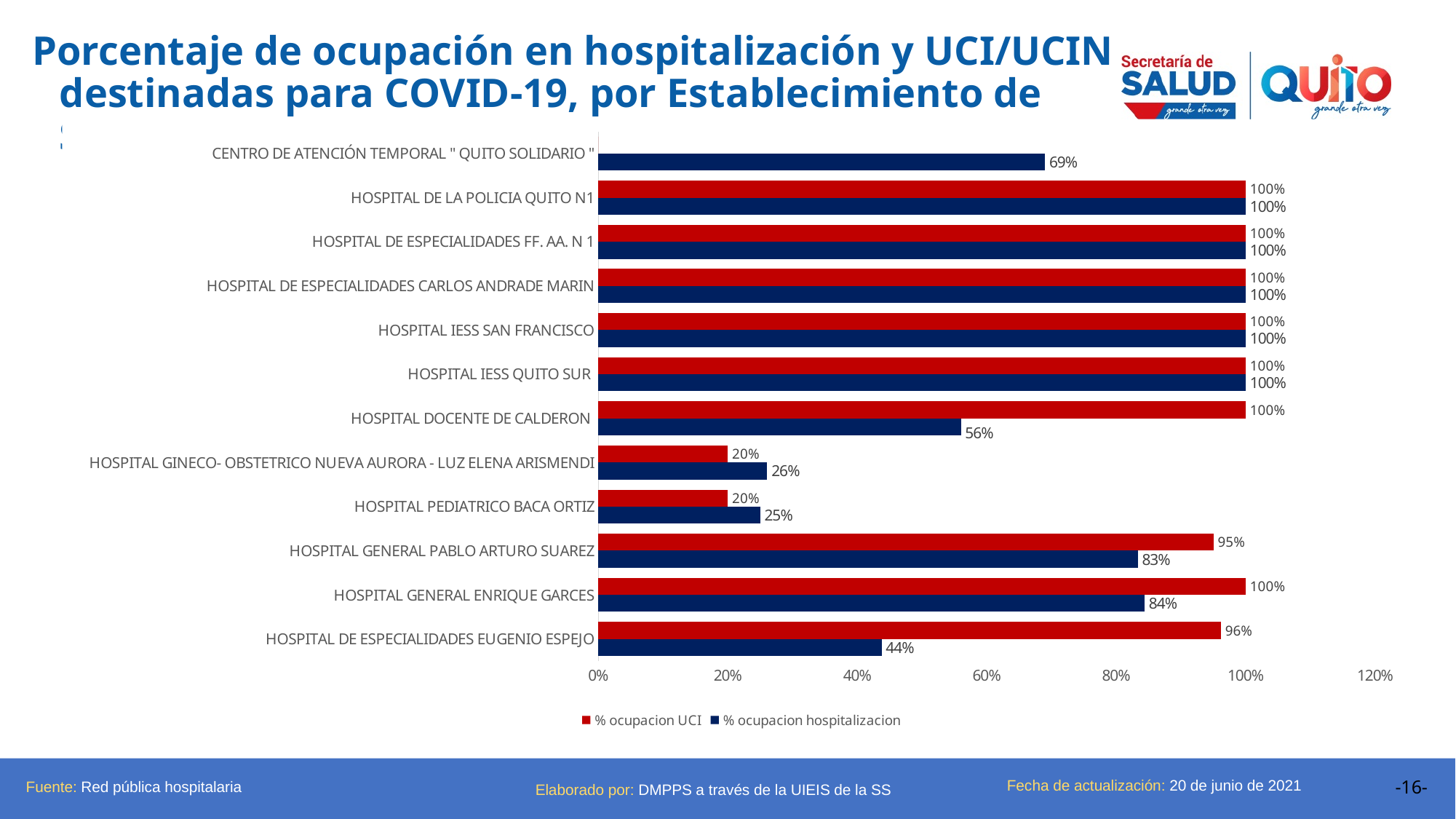
How many series does the legend list? 2 What is the % ocupacion hospitalizacion value for HOSPITAL DOCENTE DE CALDERON? 56% What is the difference between the % ocupacion hospitalizacion values for HOSPITAL GENERAL ENRIQUE GARCES and HOSPITAL GENERAL PABLO ARTURO SUAREZ? 1% What kind of chart is shown on the slide? Bar chart Which establishment has the lowest % ocupacion hospitalizacion value? HOSPITAL PEDIATRICO BACA ORTIZ What is the % ocupacion UCI value for HOSPITAL GENERAL PABLO ARTURO SUAREZ? 95% What is the difference between the % ocupacion UCI and % ocupacion hospitalizacion values for HOSPITAL DE ESPECIALIDADES EUGENIO ESPEJO? 52% How many establishments are listed on the chart? 12 Which colour represents % ocupacion UCI in the legend? Red What is the % ocupacion hospitalizacion value for HOSPITAL DE ESPECIALIDADES EUGENIO ESPEJO? 44% What is the % ocupacion hospitalizacion value for CENTRO DE ATENCIÓN TEMPORAL " QUITO SOLIDARIO "? 69% Which is larger for HOSPITAL PEDIATRICO BACA ORTIZ: % ocupacion UCI or % ocupacion hospitalizacion? % ocupacion hospitalizacion